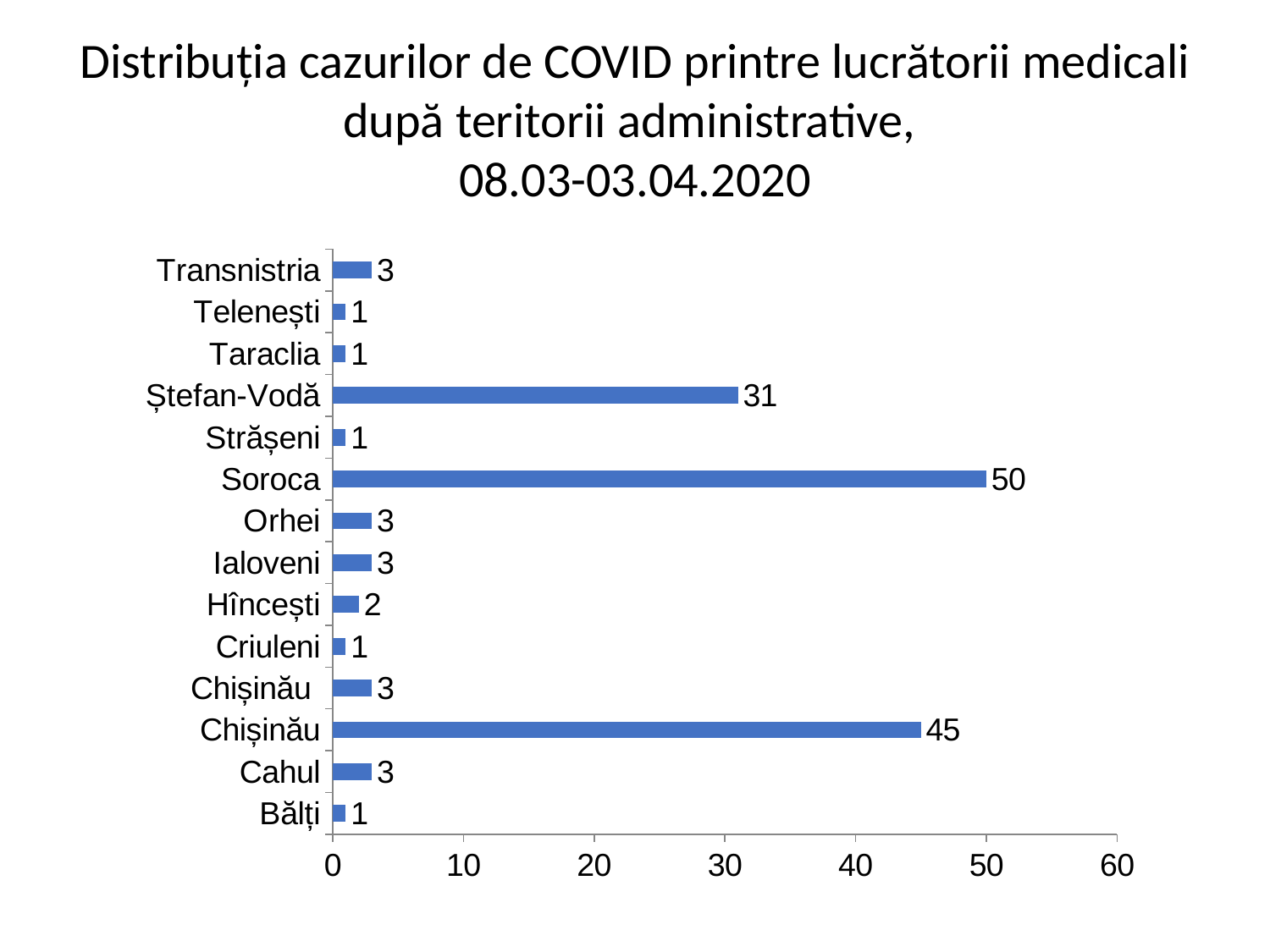
Which territory has the highest number of cases? Soroca What is the lowest value shown on the chart? 1 What is the value for Hîncești? 2 How many cases are shown for Soroca? 50 How many territories are listed on the chart? 14 What is the value for Bălți? 1 Which has a larger value, Ștefan-Vodă or Orhei? Ștefan-Vodă What type of chart is shown on the slide? bar chart What is the difference between the values for Soroca and Ștefan-Vodă? 19 What is the highest value shown on the horizontal axis? 60 What is the value for Ștefan-Vodă? 31 What is the value for Cahul? 3